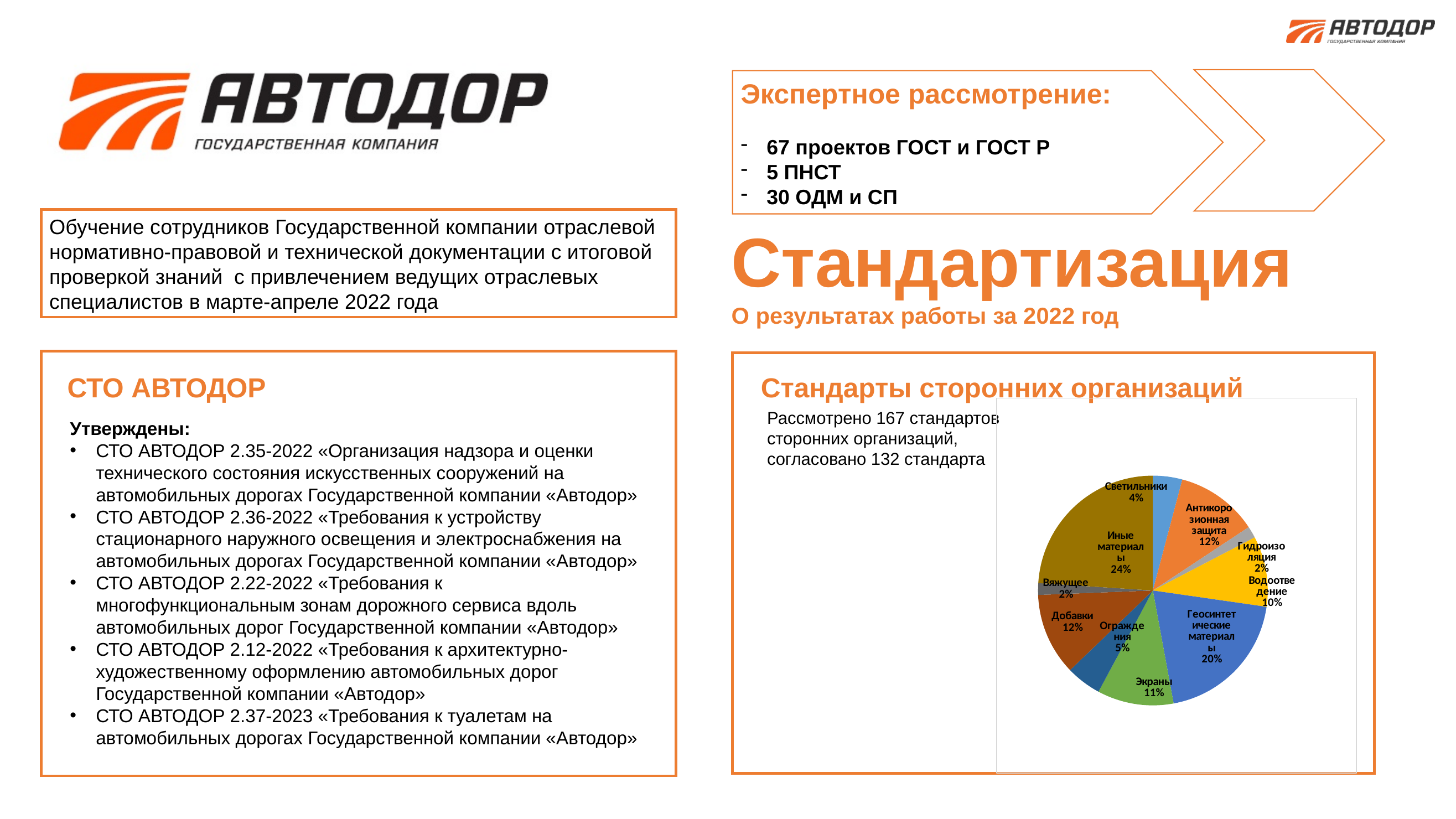
How many slices does the pie chart have? 10 What is the value shown for Экраны? 11% What is the combined share of Гидроизоляция and Вяжущее? 4% What is the value shown for Добавки? 12% What share of the pie does Иные материалы have? 24% What is the value shown for Водоотведение? 10% What is the value shown for Светильники? 4% What share of the pie does Геосинтетические материалы have? 20% What is the difference between the shares of Иные материалы and Геосинтетические материалы? 4% What kind of chart is shown on the slide? pie chart Which is larger, Антикоррозионная защита or Ограждения? Антикоррозионная защита Which category has the largest slice of the pie? Иные материалы